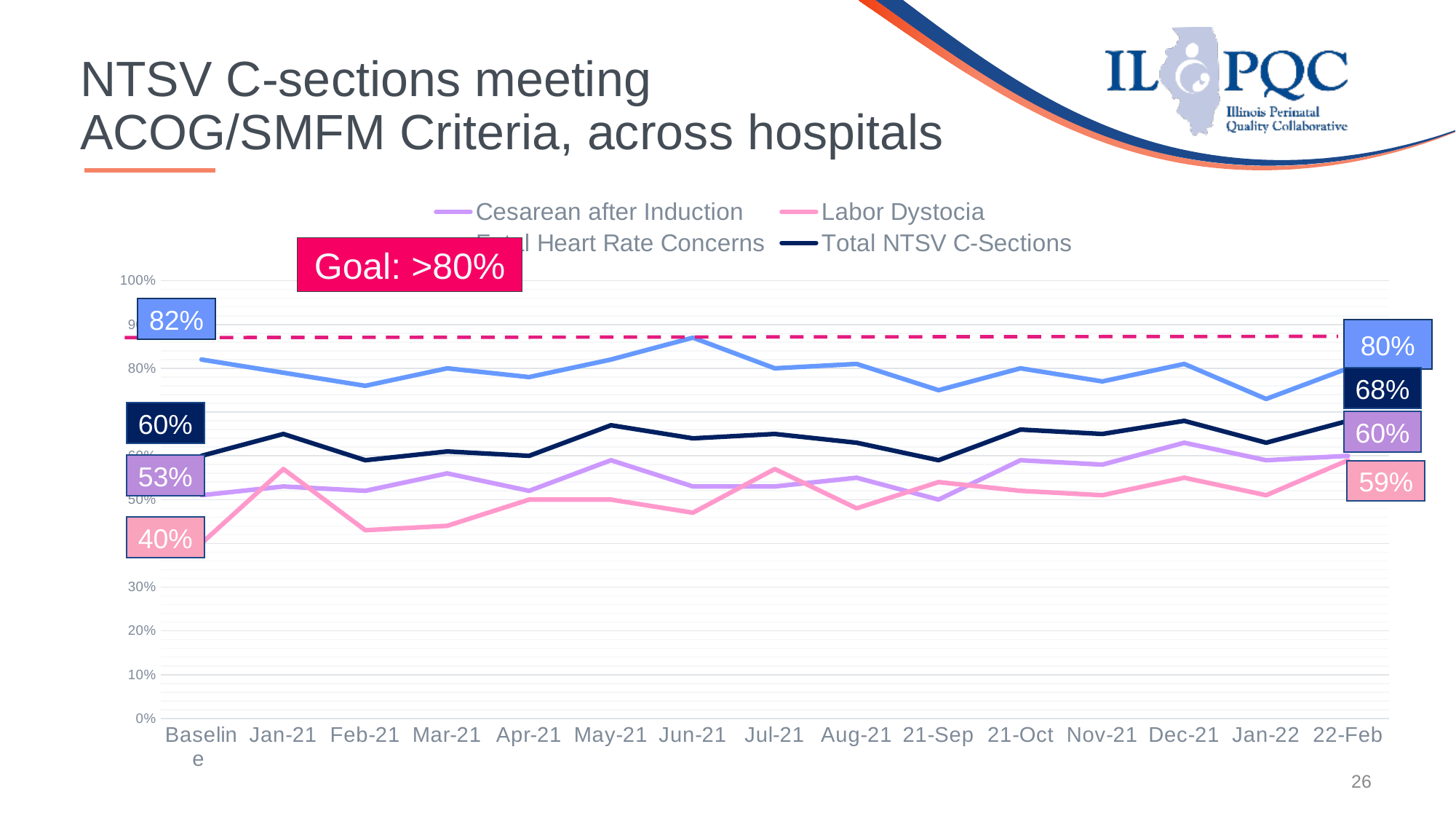
What is the value of Labor Dystocia at 22-Feb? 59% At Baseline, which is larger: Cesarean after Induction or Labor Dystocia? Cesarean after Induction Is the value for Labor Dystocia at Feb-21 greater or less than 50%? less What is the value of Total NTSV C-Sections at Baseline? 60% What kind of chart is shown on the slide? line chart What goal is stated on the chart? >80% What is the value of Labor Dystocia at Baseline? 40% How many series does the legend list? 4 What is the value of Total NTSV C-Sections at 22-Feb? 68% How many time points are shown along the x axis? 15 By how many percentage points did Labor Dystocia change from Baseline (40%) to 22-Feb (59%)? 19 percentage points What is the value of Cesarean after Induction at 22-Feb? 60%